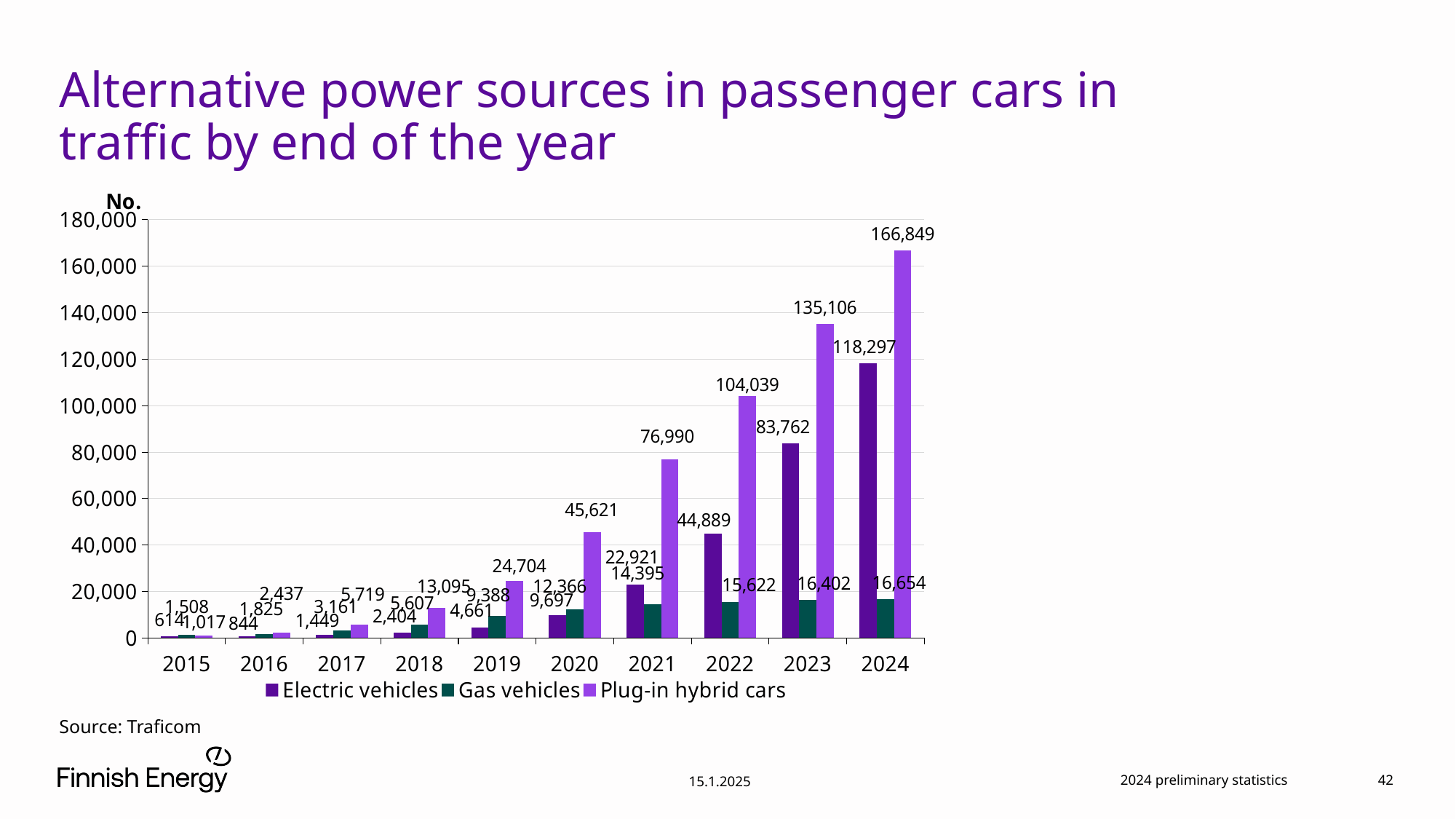
What is the difference between Plug-in hybrid cars and Electric vehicles in 2024? 48,552 What is the value for Plug-in hybrid cars in 2020? 45,621 What is the value for Gas vehicles in 2022? 15,622 Which series has the lowest value in 2024? Gas vehicles How many years are shown on the x axis? 10 Do the Plug-in hybrid cars values rise or fall from 2015 to 2024? Rise In which year is the Electric vehicles value highest? 2024 Which is larger in 2021, Electric vehicles or Gas vehicles? Electric vehicles What kind of chart is shown on the slide? Bar chart What is the value for Electric vehicles in 2023? 83,762 How many series does the legend list? 3 What is the value for Plug-in hybrid cars in 2024? 166,849